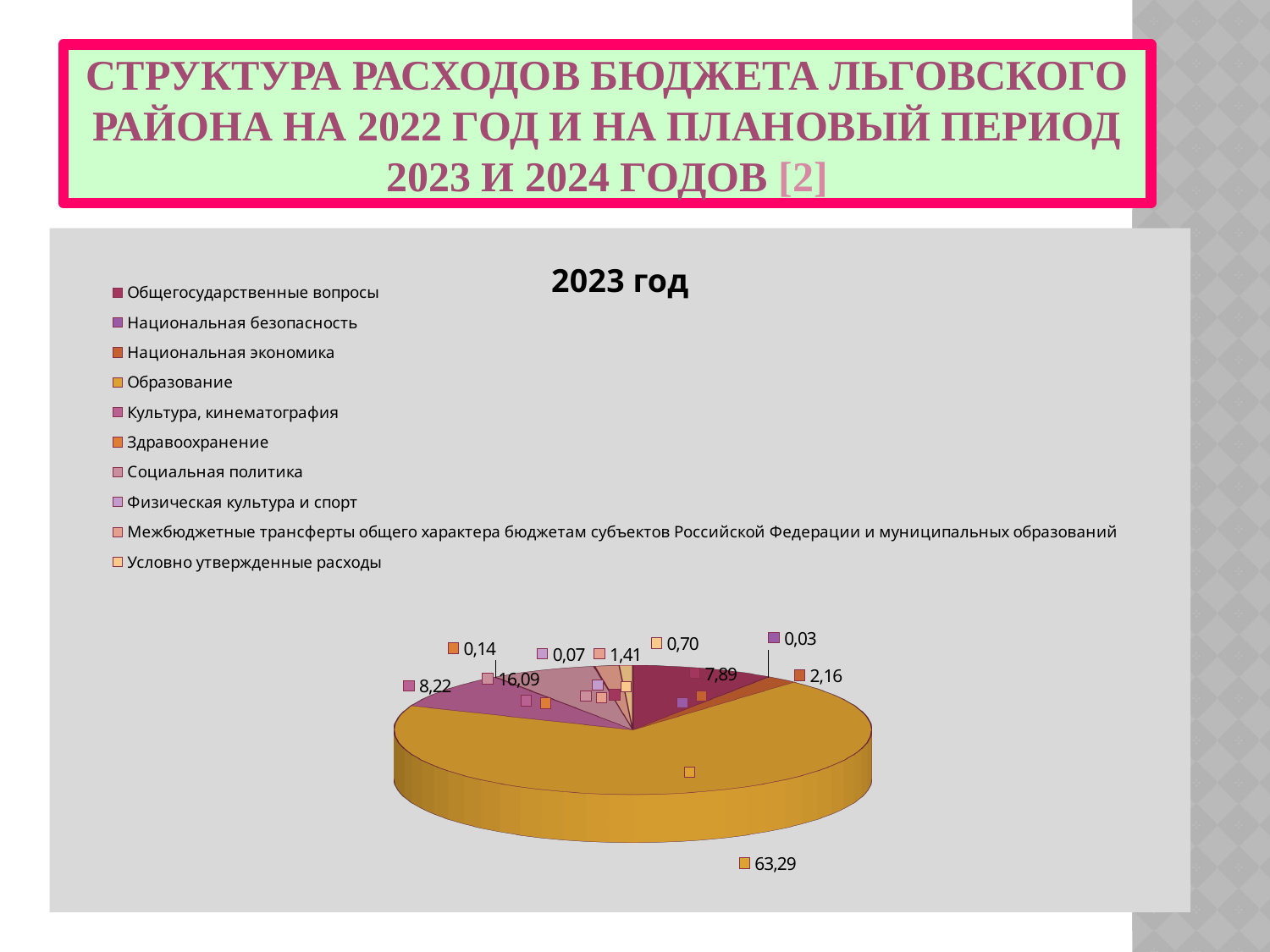
What is the title of the chart? 2023 год What type of chart is shown on the slide? pie chart What is the value shown for Общегосударственные вопросы? 7,89 How many categories does the legend of the pie chart list? 10 What is the value shown for Культура, кинематография? 8,22 What is the value shown for Национальная экономика? 2,16 What is the value shown for Социальная политика? 16,09 What is the value shown for Национальная безопасность? 0,03 Which is larger, the value for Социальная политика or the value for Культура, кинематография? Социальная политика What is the value shown for Образование? 63,29 Which category has the largest slice of the pie? Образование